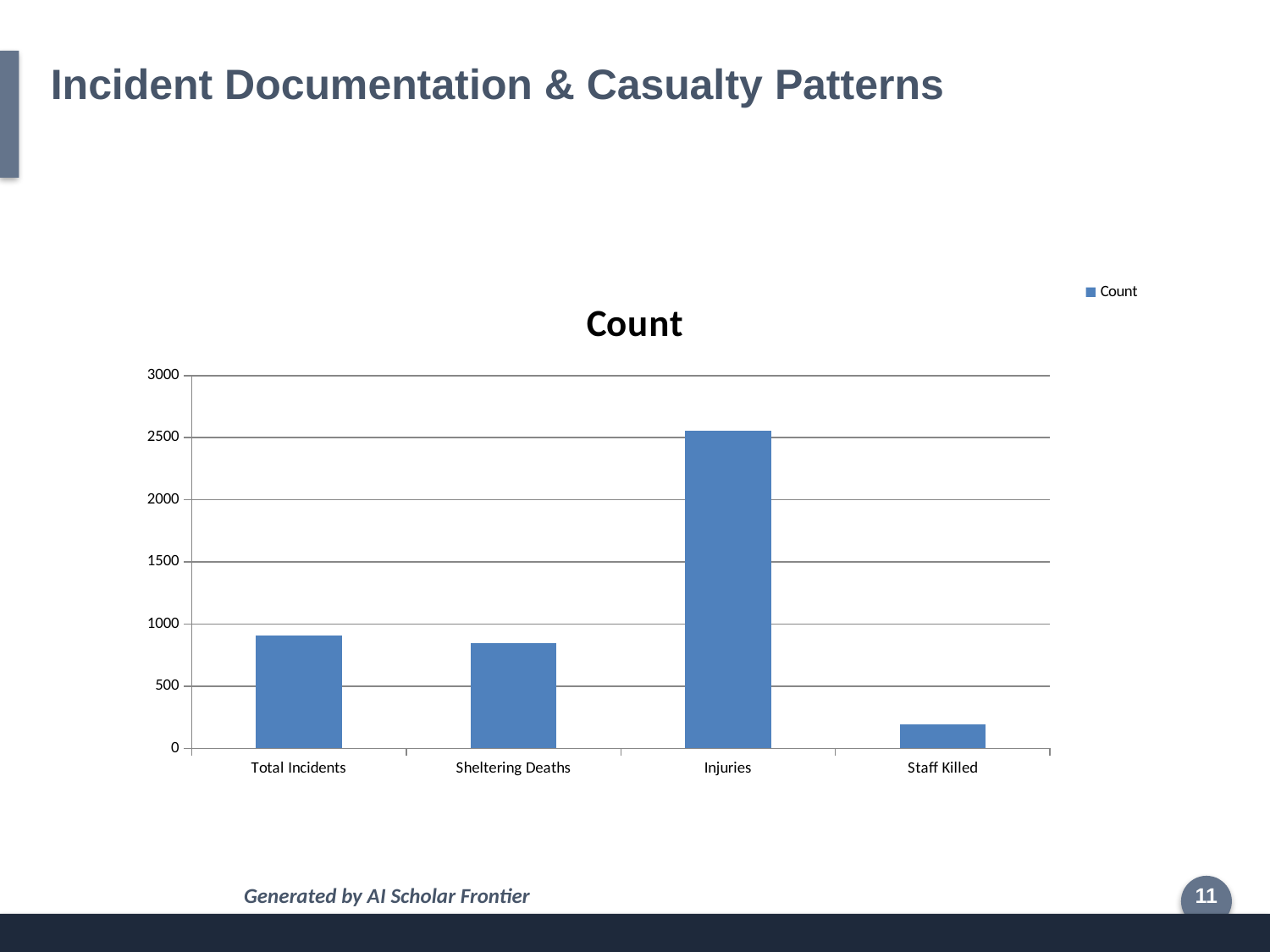
Which category has the lowest value? Staff Killed Is the value for Total Incidents greater or less than 1000? less Which is larger, the value for Injuries or the value for Total Incidents? Injuries Is the value for Staff Killed greater or less than 500? less How many series does the legend list? 1 Is the value for Sheltering Deaths greater or less than 500? greater What kind of chart is shown on the slide? bar chart What is the title of the chart? Count Which is larger, the value for Sheltering Deaths or the value for Staff Killed? Sheltering Deaths Which category has the highest value? Injuries How many categories are shown on the x axis of the chart? 4